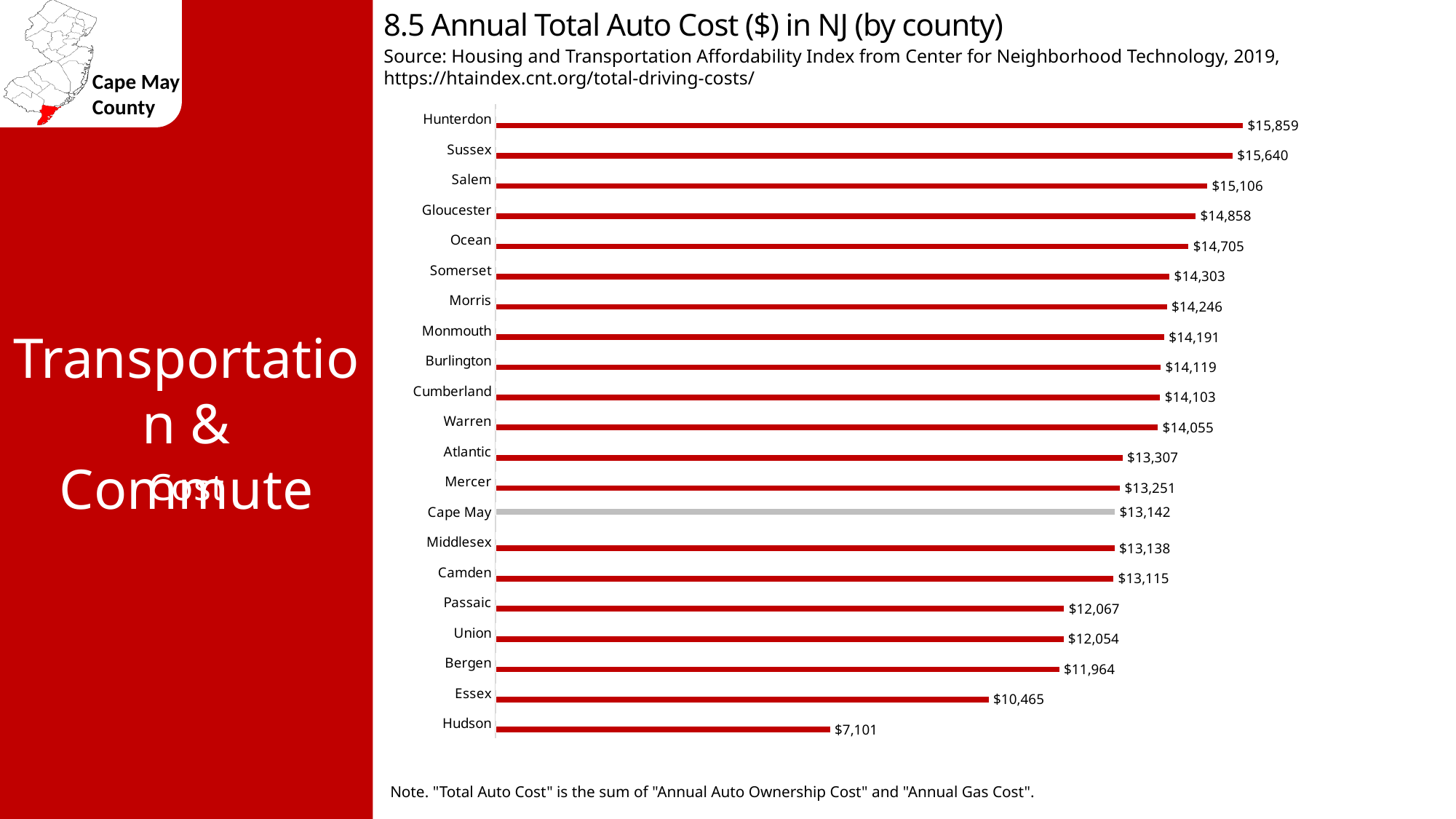
What is the annual total auto cost for Cape May county? $13,142 How many counties are shown in the chart? 21 Which county's bar is shown in a different colour (grey) from the others? Cape May Which county has the highest annual total auto cost? Hunterdon What is the annual total auto cost for Hunterdon county? $15,859 What is the annual total auto cost for Essex county? $10,465 Which county has a higher annual total auto cost, Bergen or Essex? Bergen What is the difference in annual total auto cost between Hunterdon and Hudson counties? $8,758 Which county has a higher annual total auto cost, Sussex or Salem? Sussex What is the difference in annual total auto cost between Cape May and Essex counties? $2,677 What type of chart is shown on the slide? Bar chart Which county has the lowest annual total auto cost? Hudson